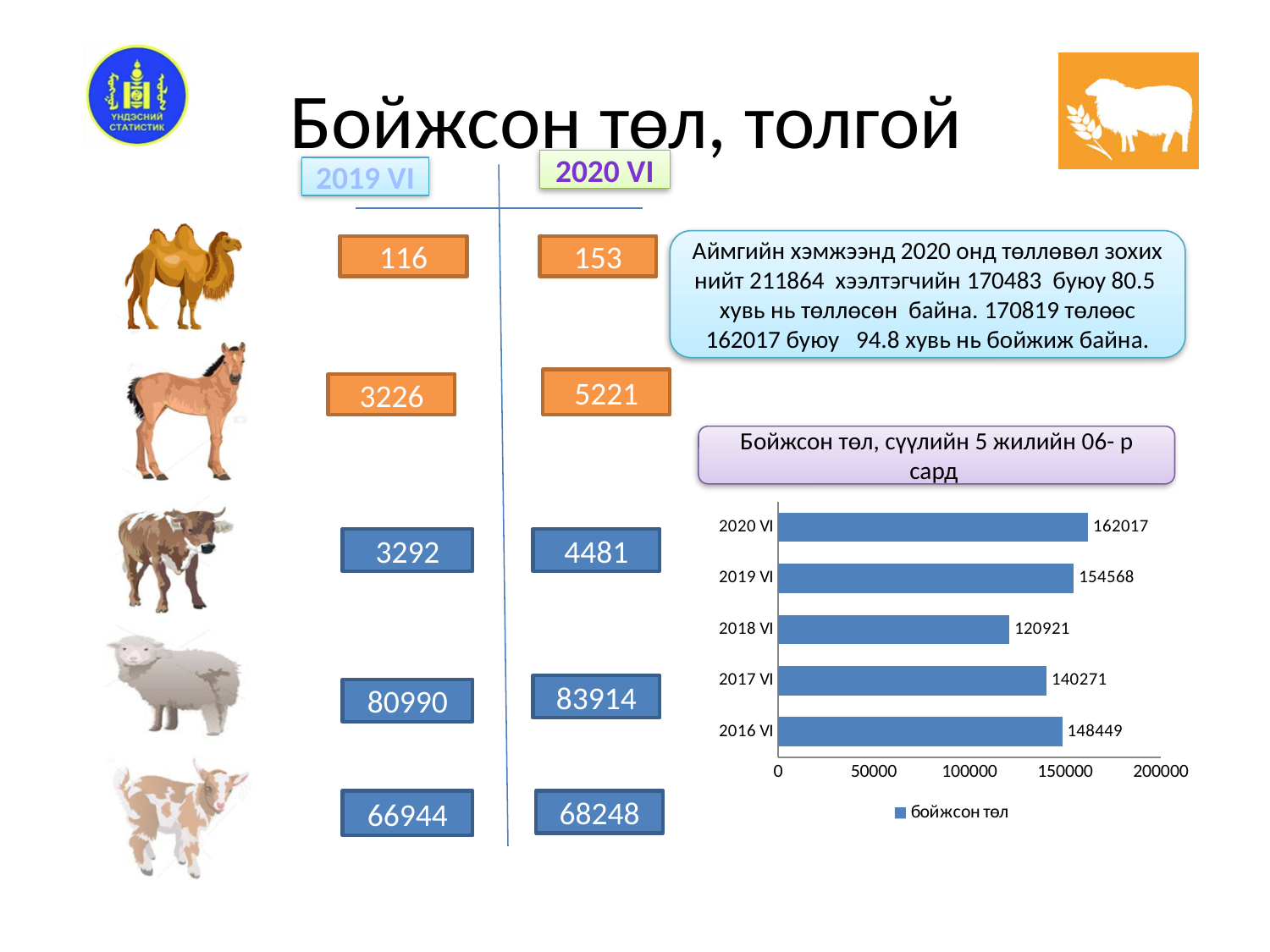
What is the value for 2018 VI in the bar chart? 120921 What is the legend entry of the bar chart? бойжсон төл What is the difference between the values for 2016 VI and 2017 VI in the bar chart? 8178 What is the difference between the values for 2020 VI and 2019 VI in the bar chart? 7449 Which is larger in the bar chart, the value for 2017 VI or 2018 VI? 2017 VI Is the value for 2019 VI in the bar chart greater or less than 150000? greater Which year has the lowest value in the bar chart? 2018 VI What is the value for 2016 VI in the bar chart? 148449 What type of chart is shown on the slide? bar chart What is the value for 2020 VI in the bar chart? 162017 How many years are shown in the bar chart? 5 Which year has the highest value in the bar chart? 2020 VI